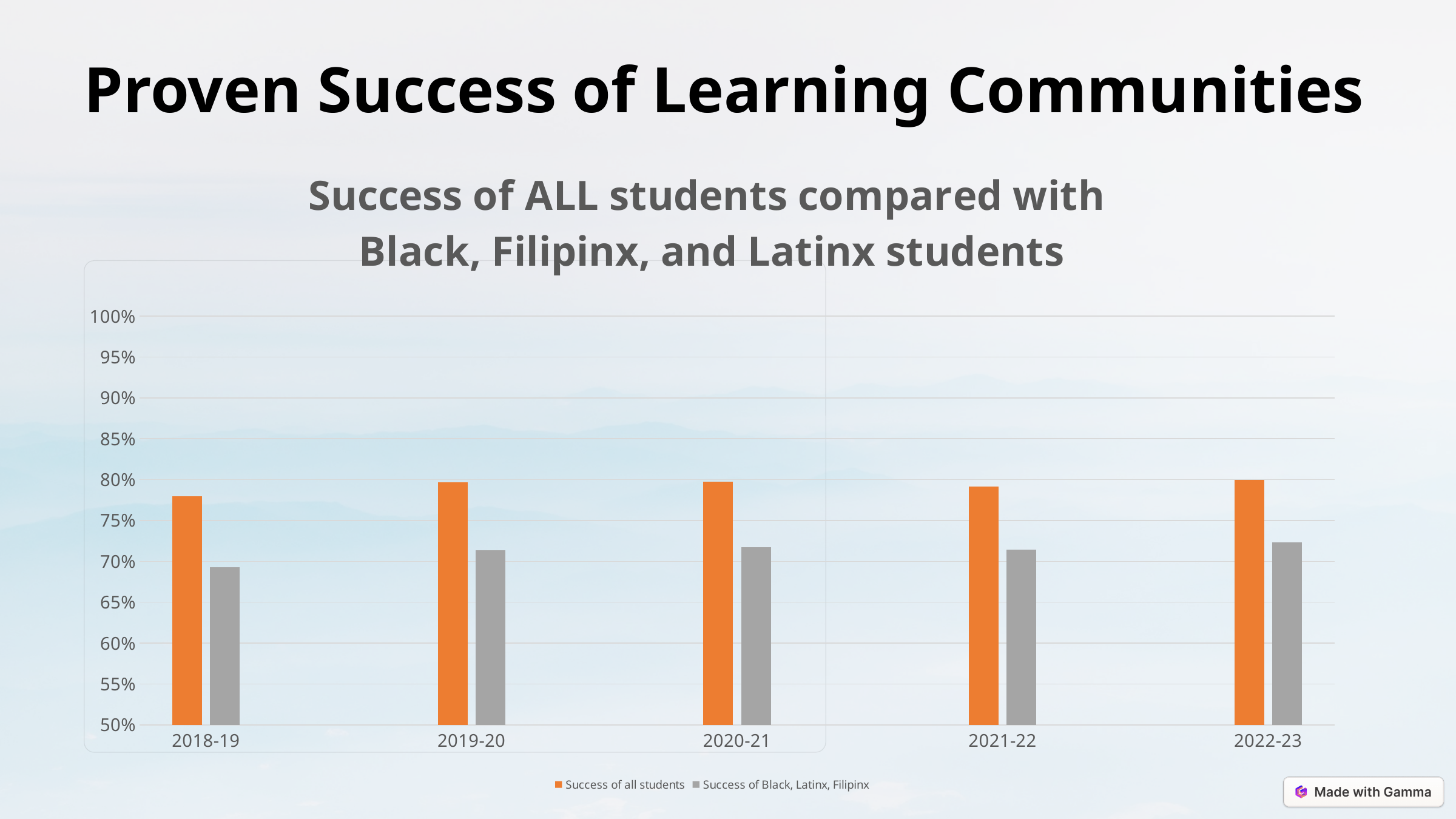
In which year is the Success of Black, Latinx, Filipinx value the lowest? 2018-19 How many series does the chart's legend list? 2 Is the value for Success of Black, Latinx, Filipinx in 2021-22 greater or less than 75%? less In 2020-21, which is larger: Success of all students or Success of Black, Latinx, Filipinx? Success of all students Is the value for Success of all students in 2019-20 greater or less than 85%? less Is the value for Success of Black, Latinx, Filipinx in 2018-19 greater or less than 70%? less How many academic years are shown on the x axis of the chart? 5 In which year is the Success of all students value the lowest? 2018-19 Which colour represents Success of all students in the chart? orange What kind of chart is shown on the slide? bar chart